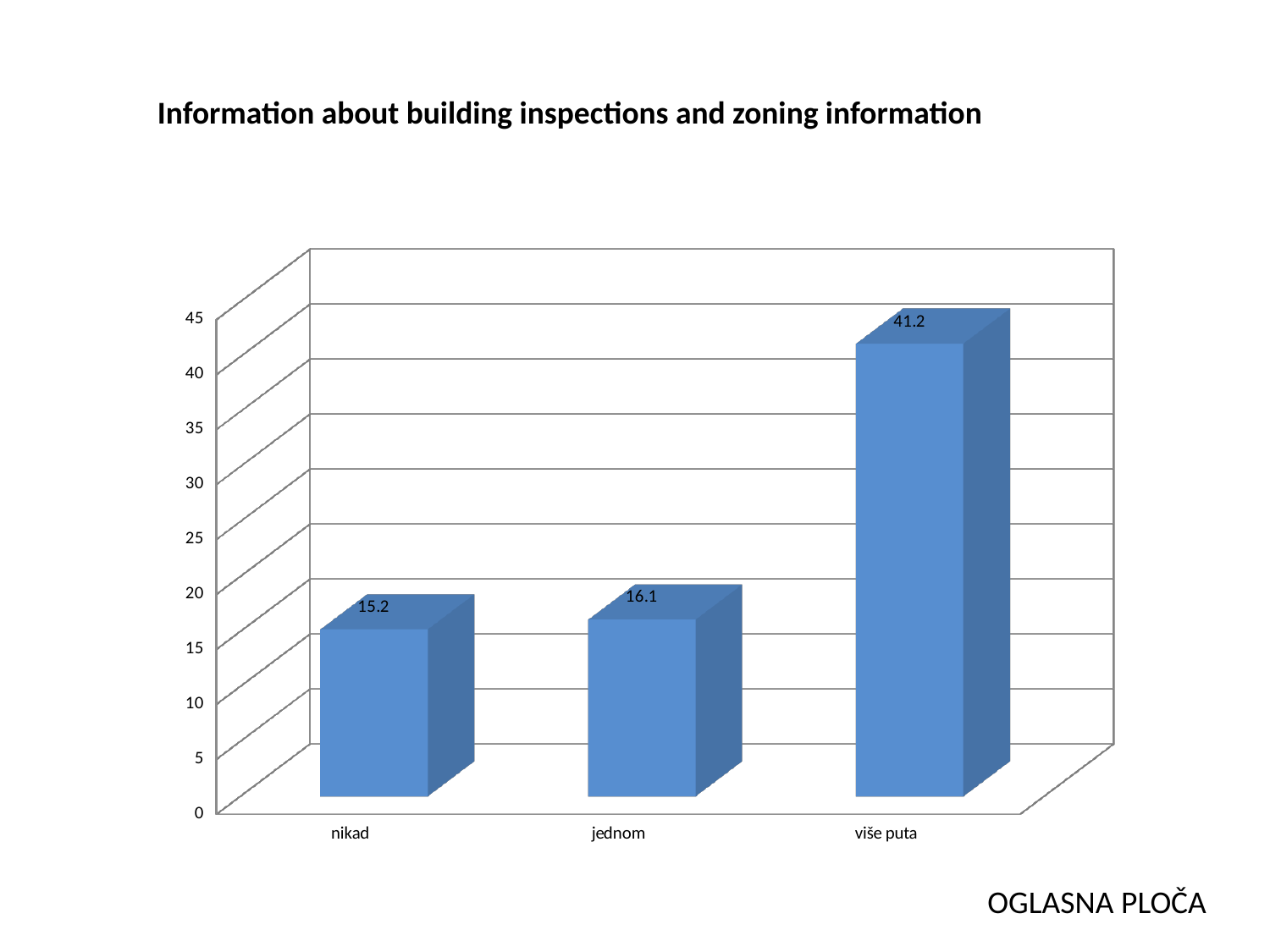
What kind of chart is shown on the slide? bar chart What is the value for "nikad"? 15.2 What is the value for "jednom"? 16.1 Which category has the highest value? više puta What is the title of the slide above the chart? Information about building inspections and zoning information Is the value for "više puta" greater or less than 40? greater What is the difference between the values for "jednom" and "nikad"? 0.9 What is the difference between the values for "više puta" and "jednom"? 25.1 How many categories are shown on the x axis? 3 What is the value for "više puta"? 41.2 Which category has the lowest value? nikad Which is larger, the value for "nikad" or the value for "više puta"? više puta